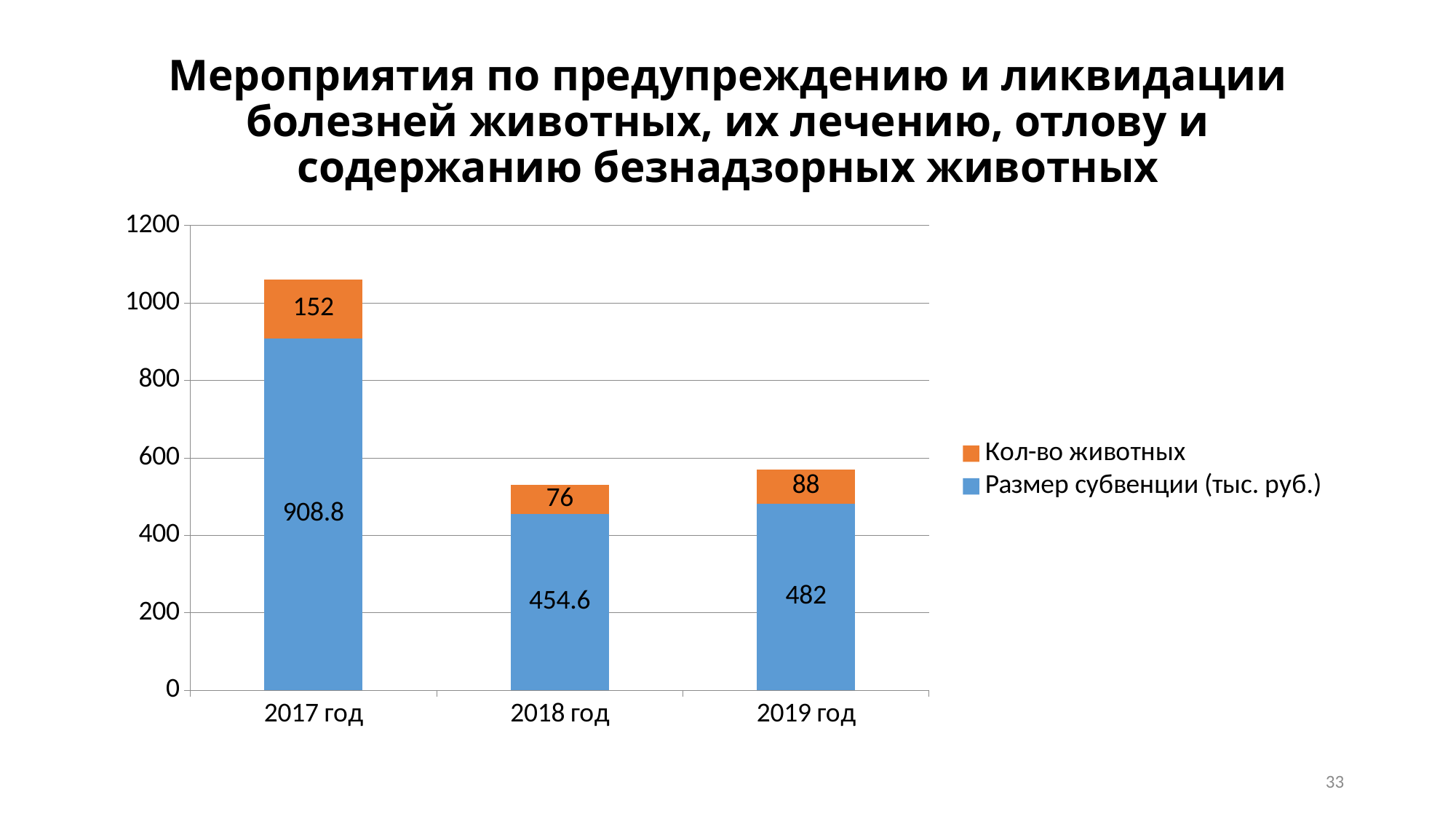
What is the total of the stacked bar for 2019 год? 570 What is the value of Кол-во животных for 2019 год? 88 What is the value of Кол-во животных for 2018 год? 76 What is the difference between the Размер субвенции (тыс. руб.) values for 2017 год and 2018 год? 454.2 Which year has the highest value for Размер субвенции (тыс. руб.)? 2017 год Which colour represents Кол-во животных in the chart? Orange Which is larger: the Размер субвенции (тыс. руб.) value for 2019 год or for 2018 год? 2019 год How many series does the legend list? 2 How many years are shown on the x axis? 3 Which year has the lowest value for Кол-во животных? 2018 год What is the value of Размер субвенции (тыс. руб.) for 2017 год? 908.8 What kind of chart is shown on the slide? Stacked bar chart